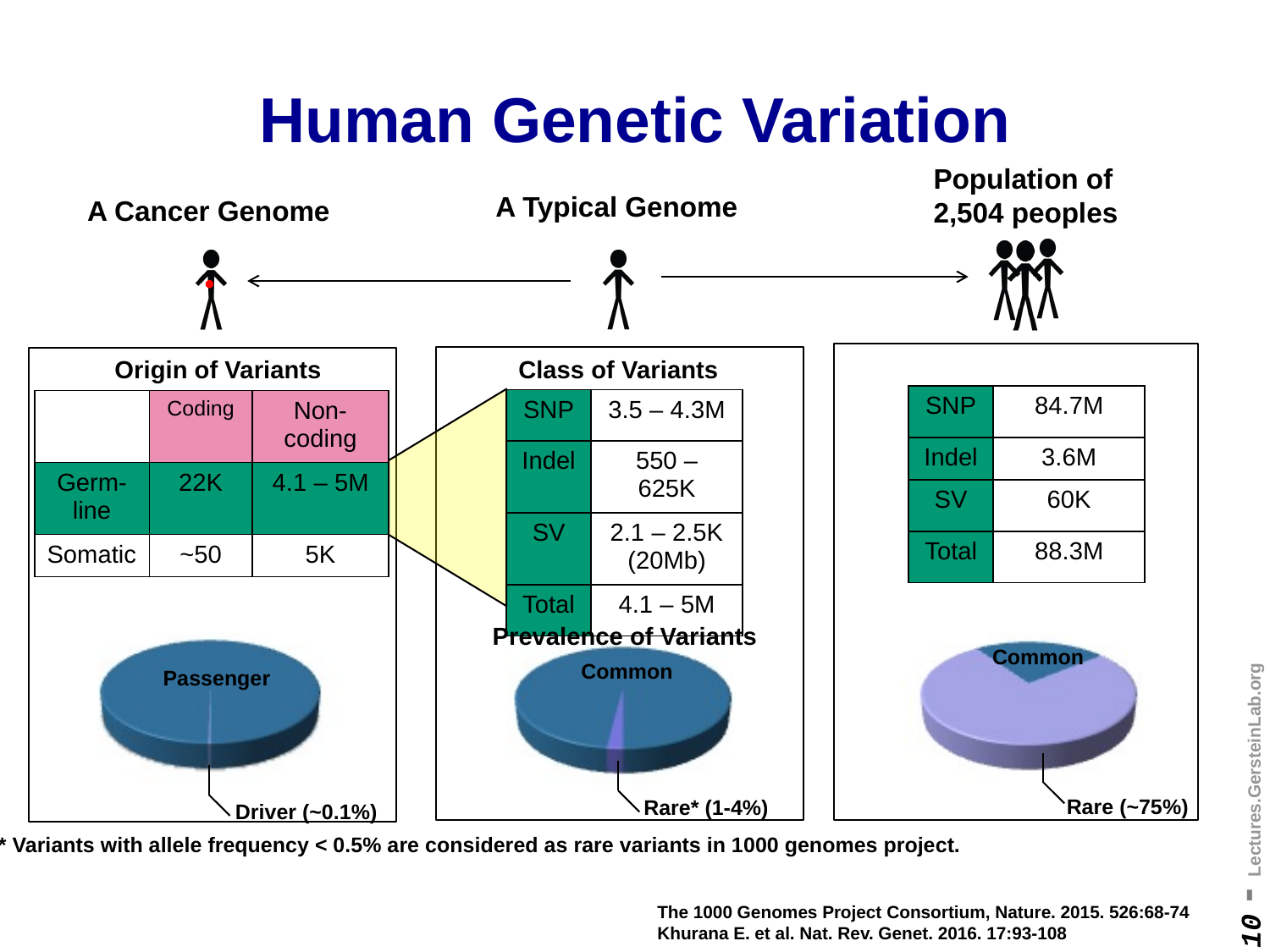
In the 'Population of 2,504 peoples' pie chart, which slice is the largest? Rare How many pie charts are shown on the slide? 3 In the 'A Typical Genome' pie chart, which slice is the largest? Common In the 'A Typical Genome' pie chart, which slice is smaller, Common or Rare*? Rare* In the 'A Cancer Genome' pie chart, which slice is larger, Passenger or Driver? Passenger What heading appears directly above the 'A Typical Genome' pie chart? Prevalence of Variants What kind of chart is shown at the bottom of the 'A Cancer Genome' panel? Pie chart In the 'A Cancer Genome' pie chart, how many slices are there? 2 In the 'Population of 2,504 peoples' pie chart, which slice is the smallest? Common In the 'Population of 2,504 peoples' pie chart, how many slices are there? 2 In the 'Population of 2,504 peoples' pie chart, is the Rare slice greater or less than half of the pie? greater In the 'A Cancer Genome' pie chart, which slice is the smallest? Driver